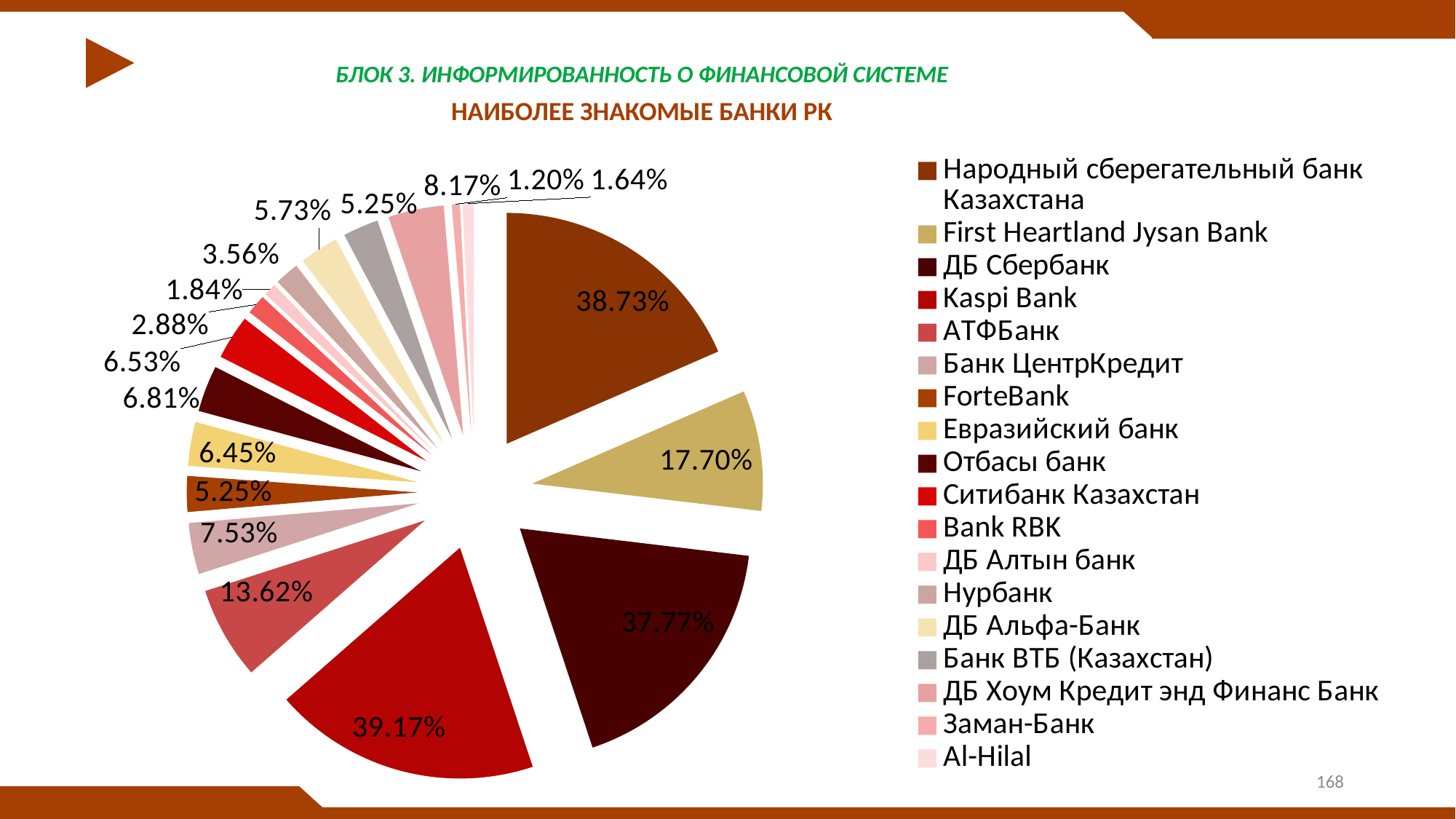
What is the difference between the values for Kaspi Bank and ДБ Сбербанк? 1.40% Which bank has the lowest value in the pie chart? Заман-Банк Which is larger, the value for Банк ЦентрКредит or the value for Отбасы банк? Банк ЦентрКредит Which bank has the highest value in the pie chart? Kaspi Bank What is the value for First Heartland Jysan Bank? 17.70% What is the title of the chart? НАИБОЛЕЕ ЗНАКОМЫЕ БАНКИ РК What is the value for Kaspi Bank? 39.17% What is the value for АТФБанк? 13.62% What is the value for Народный сберегательный банк Казахстана? 38.73% How many banks are listed in the legend of the pie chart? 18 What is the value for ДБ Хоум Кредит энд Финанс Банк? 8.17% What type of chart is shown on the slide? pie chart